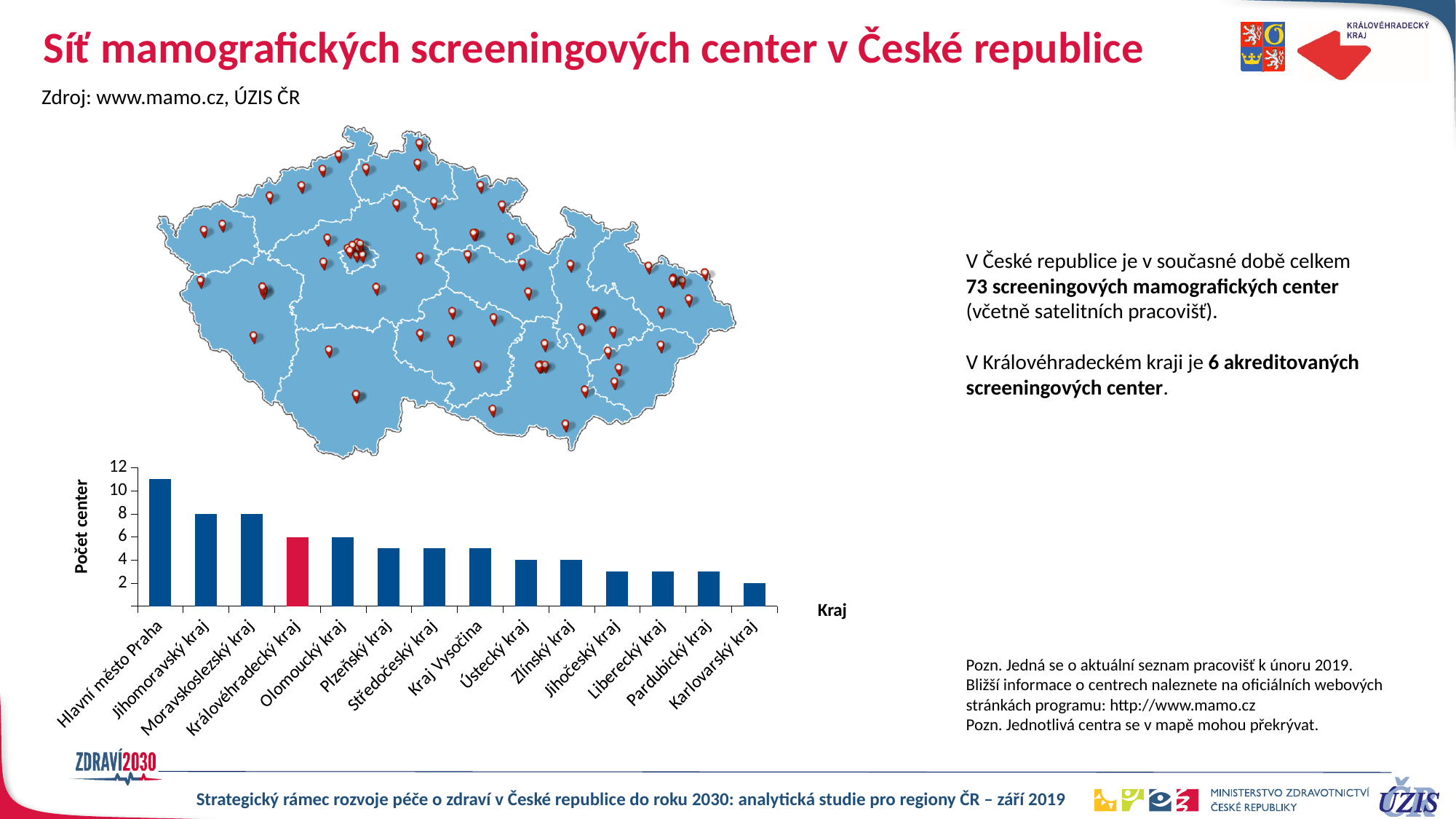
Which region has the highest number of centres in the bar chart? Hlavní město Praha Is the value for Hlavní město Praha greater or less than 10? greater How many regions (kraje) are shown on the x axis of the bar chart? 14 Is the value for Plzeňský kraj greater or less than 6? less How many centres does the bar chart show for Královéhradecký kraj? 6 What kind of chart is shown on the slide? bar chart How many centres does the bar chart show for Karlovarský kraj? 2 Which region's bar is highlighted in red in the bar chart? Královéhradecký kraj How many centres does the bar chart show for Jihomoravský kraj? 8 Which region has the lowest number of centres in the bar chart? Karlovarský kraj What is the difference between the number of centres in Jihomoravský kraj and Královéhradecký kraj? 2 Which has more centres, Olomoucký kraj or Ústecký kraj? Olomoucký kraj